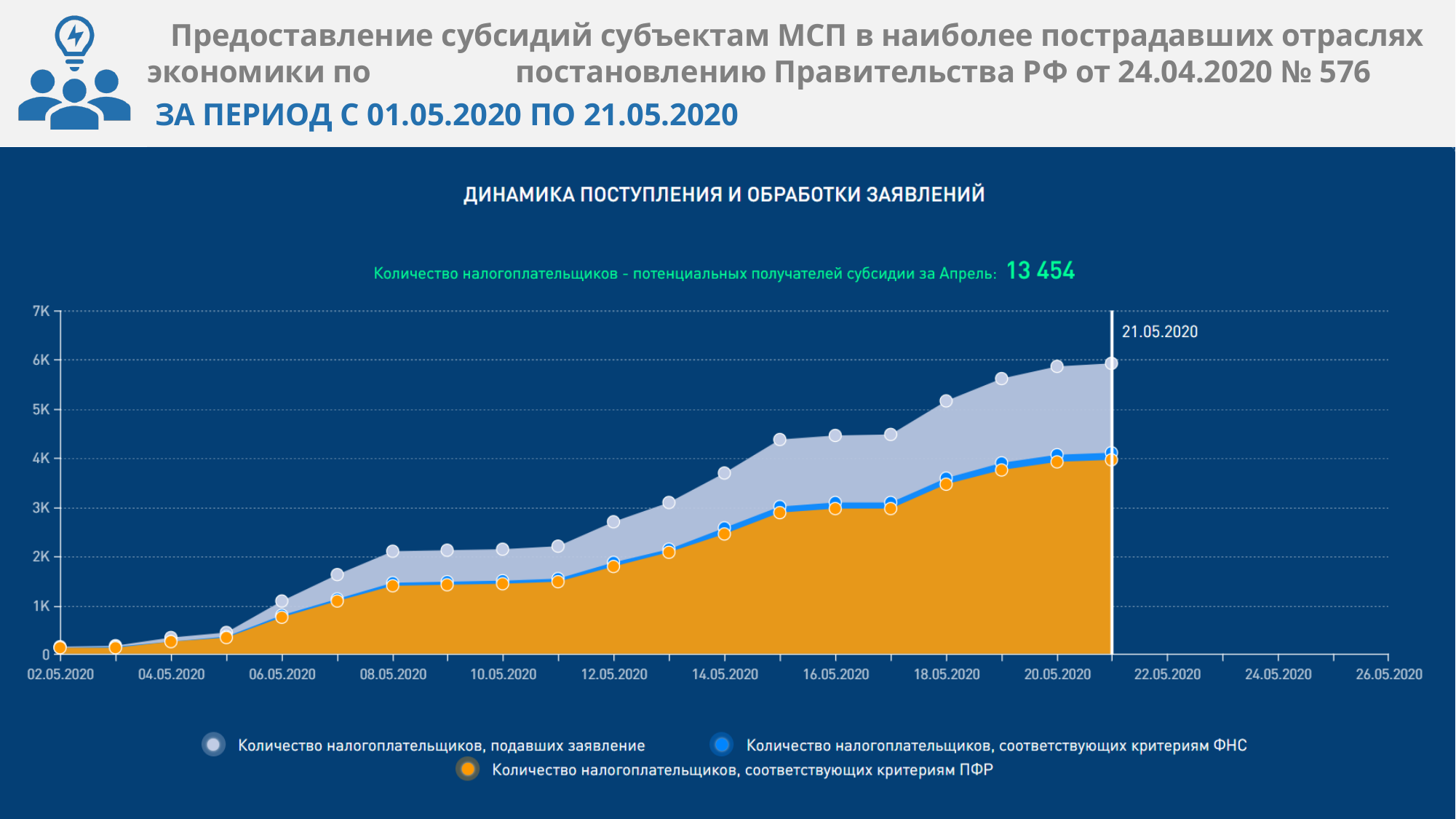
How many series does the legend list? 3 Which series has the highest value on 21.05.2020? Количество налогоплательщиков, подавших заявление What is the title of the chart? ДИНАМИКА ПОСТУПЛЕНИЯ И ОБРАБОТКИ ЗАЯВЛЕНИЙ What number of taxpayers – potential subsidy recipients for April is stated above the chart? 13 454 Is the value for 'Количество налогоплательщиков, соответствующих критериям ПФР' on 12.05.2020 greater or less than 2K? less Do the values for 'Количество налогоплательщиков, подавших заявление' rise or fall from 02.05.2020 to 21.05.2020? Rise Is the value for 'Количество налогоплательщиков, соответствующих критериям ФНС' on 10.05.2020 greater or less than 1K? greater Is the value for 'Количество налогоплательщиков, подавших заявление' on 21.05.2020 greater or less than 5K? greater What kind of chart is shown on the slide? Area chart How many data points are plotted for each series? 20 On 21.05.2020, which is larger: 'Количество налогоплательщиков, подавших заявление' or 'Количество налогоплательщиков, соответствующих критериям ПФР'? Количество налогоплательщиков, подавших заявление